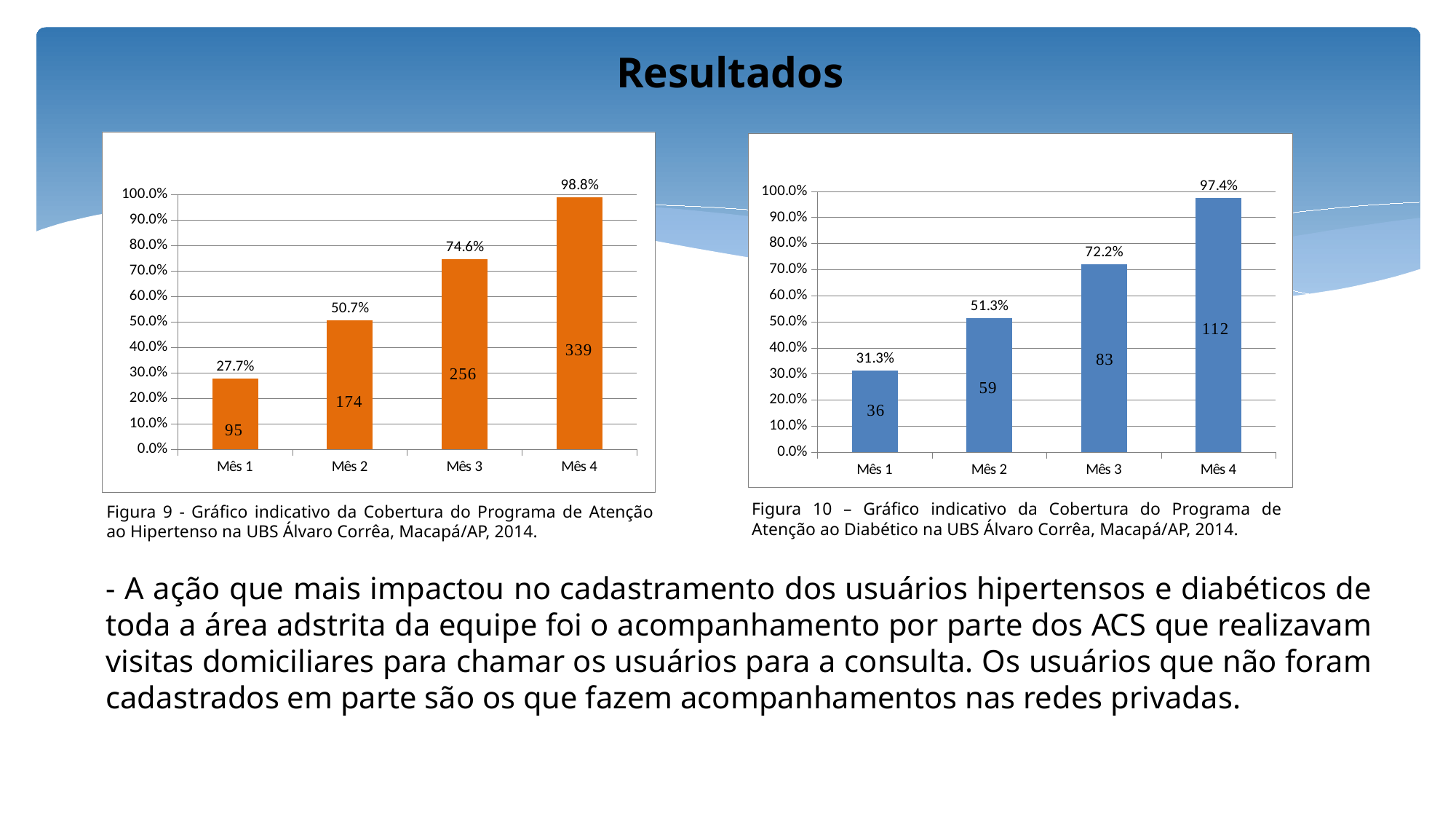
In the right chart (Figura 10, Diabético), which month has the lowest coverage? Mês 1 In the right chart (Figura 10, Diabético), do the coverage values rise or fall from Mês 1 to Mês 4? Rise In the left chart (Figura 9, Hipertenso), what number is printed inside the bar for Mês 4? 339 How many months (categories) are shown in the left chart (Figura 9, Hipertenso)? 4 In the left chart (Figura 9, Hipertenso), what is the difference in coverage between Mês 2 and Mês 1? 23.0% In the left chart (Figura 9, Hipertenso), what is the coverage percentage for Mês 3? 74.6% In the right chart (Figura 10, Diabético), what is the coverage percentage for Mês 2? 51.3% What type of chart is the right chart (Figura 10, Diabético)? Bar chart In the left chart (Figura 9, Hipertenso), which month has the highest coverage? Mês 4 In the right chart (Figura 10, Diabético), what number is printed inside the bar for Mês 1? 36 Which is larger: the Mês 1 coverage in the left chart (Hipertenso) or the Mês 1 coverage in the right chart (Diabético)? Right chart (Diabético), 31.3% In the right chart (Figura 10, Diabético), what is the difference in coverage between Mês 4 and Mês 3? 25.2%